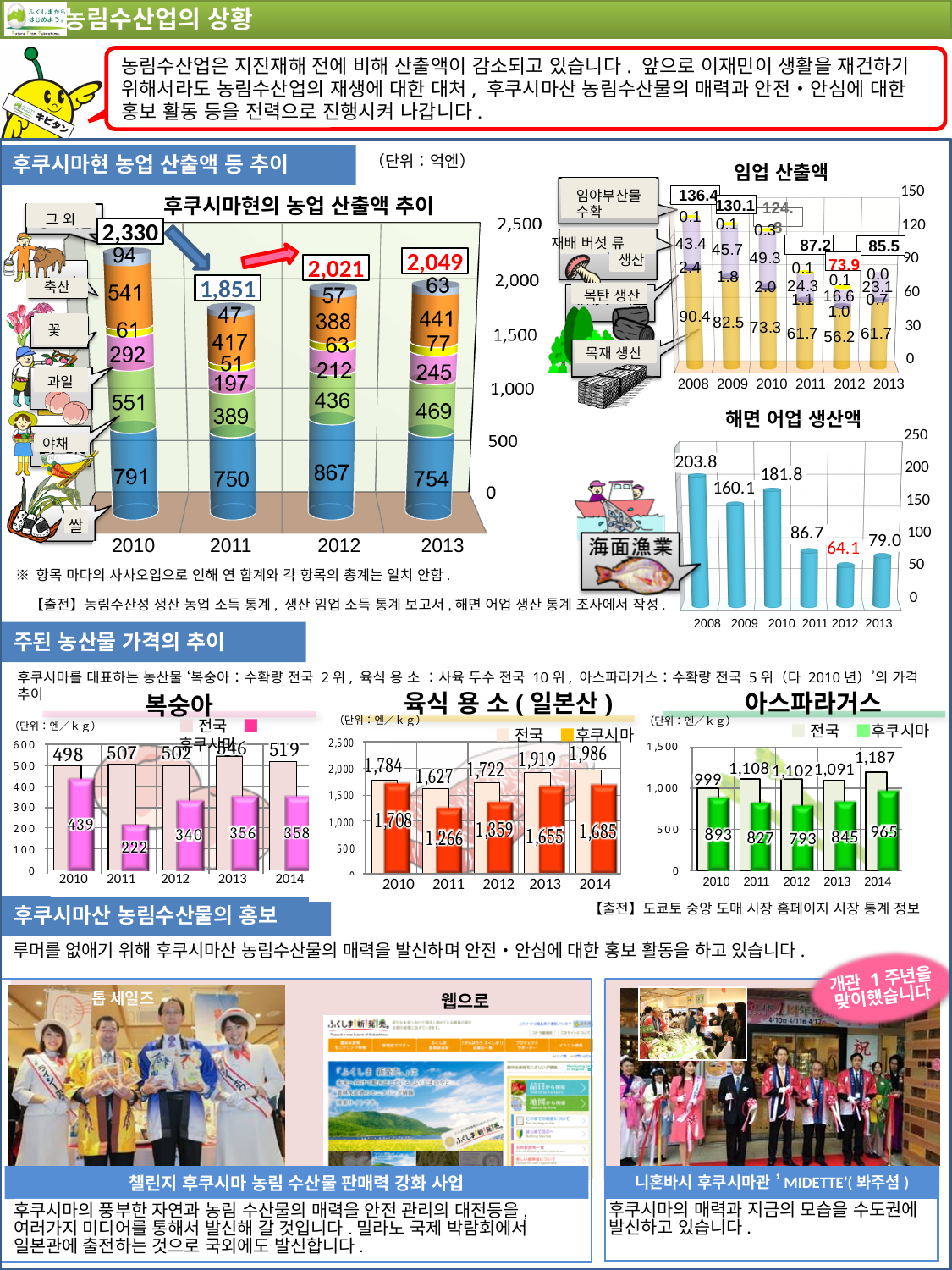
In the 임업 산출액 chart, how many years are shown on the x axis? 6 In the 해면 어업 생산액 chart, which year has the lowest value? 2012 In the 아스파라거스 chart, how many series does the legend list? 2 In the 임업 산출액 chart, what is the total for 2008? 136.4 In the 복숭아 chart, what is the 후쿠시마 value for 2011? 222 In the 복숭아 chart, which is larger in 2013, 전국 or 후쿠시마? 전국 In the 후쿠시마현의 농업 산출액 추이 chart, which year has the highest total? 2010 In the 후쿠시마현의 농업 산출액 추이 chart, what is the value of 쌀 in 2012? 867 In the 해면 어업 생산액 chart, what is the value for 2008? 203.8 In the 후쿠시마현의 농업 산출액 추이 chart, what is the total for 2011? 1,851 In the 육식 용 소 (일본산) chart, what is the difference between 전국 and 후쿠시마 in 2014? 301 In the 해면 어업 생산액 chart, what is the difference between the 2010 and 2011 values? 95.1